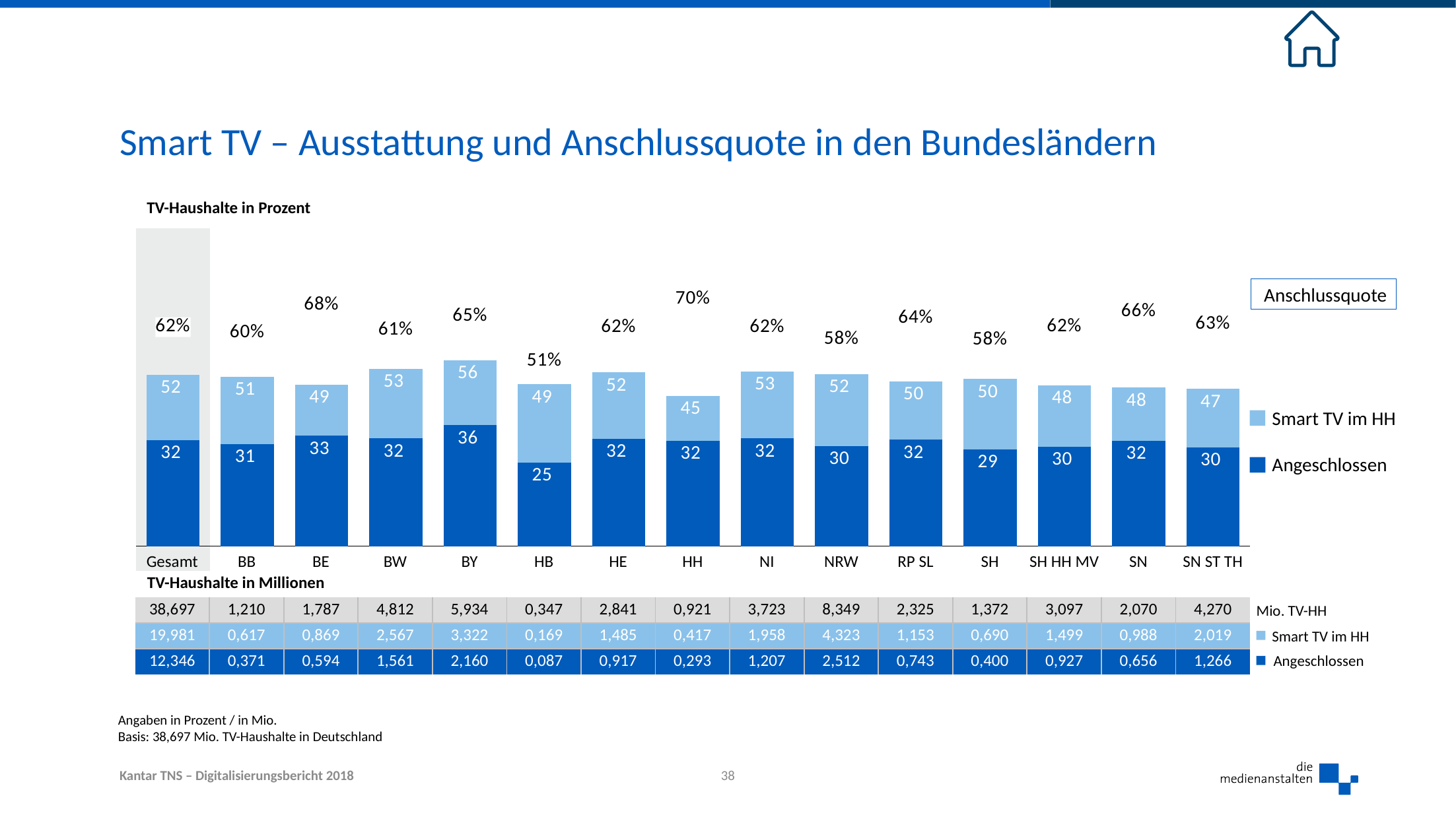
Which category has the highest Anschlussquote? HH Which category has the lowest Angeschlossen value? HB What kind of chart is shown on the slide? bar chart Which category has the highest Smart TV im HH value? BY What is the difference between the Angeschlossen values for BY and HB? 11 What are the two series names listed in the chart legend? Smart TV im HH, Angeschlossen How many series does the chart legend list? 2 What is the Smart TV im HH value for BY? 56 How many categories are shown on the x axis of the chart? 15 What is the Anschlussquote shown above the bar for HH? 70% Which has the larger Smart TV im HH value, HH or NI? NI What is the Angeschlossen value for HB? 25